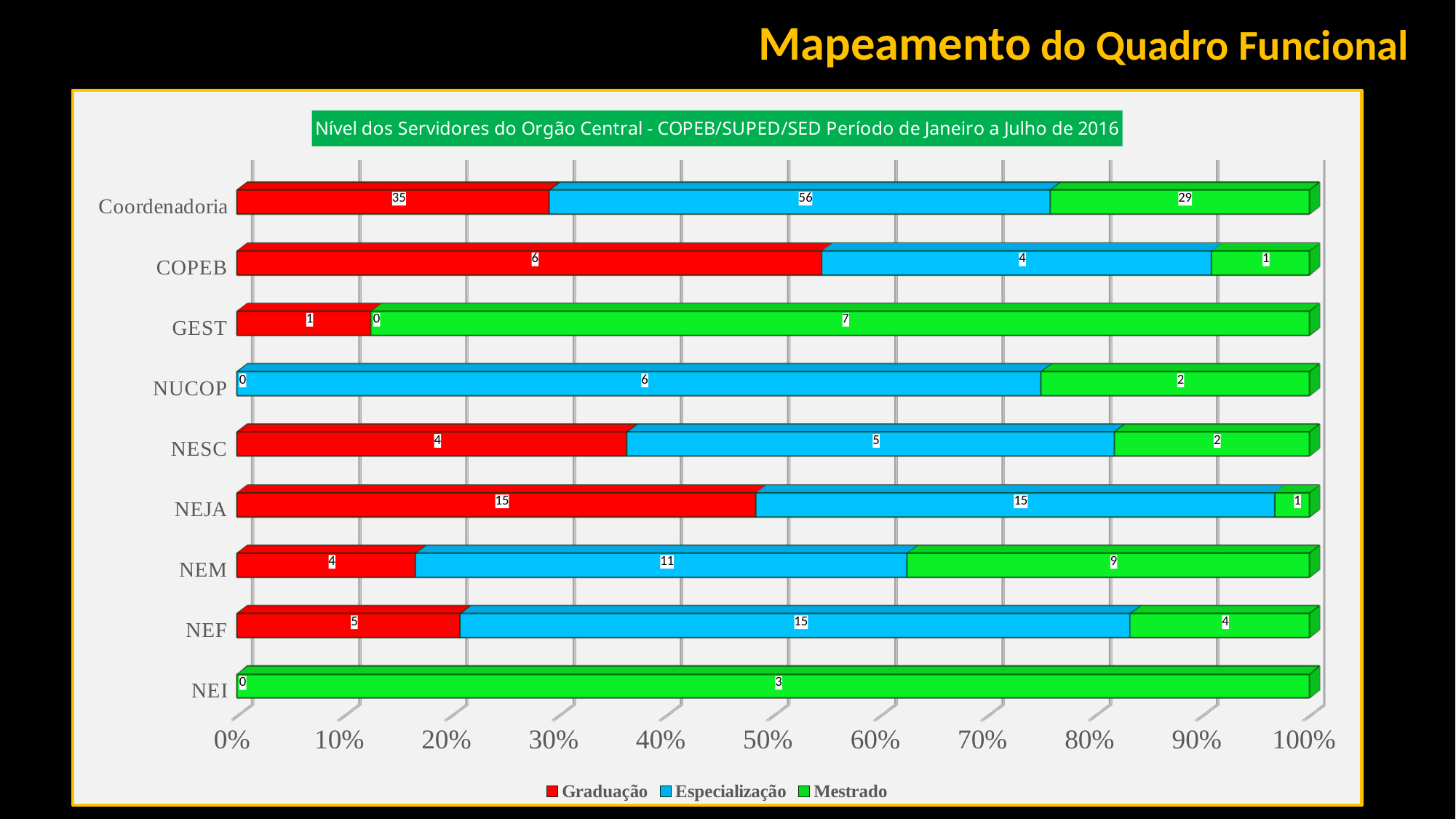
How many series does the legend list? 3 What is the Especialização value for Coordenadoria? 56 What is the Mestrado value for NEM? 9 Which is larger for NEM: the Especialização value or the Graduação value? Especialização What kind of chart is shown on the slide? Stacked bar chart How many categories are shown on the vertical axis? 9 What is the Graduação value for NEJA? 15 What is the total of the three values in the Coordenadoria bar? 120 Which colour represents the Mestrado series in the legend? Green What is the total of the three values in the NEM bar? 24 What is the difference between the Especialização and Graduação values for NEF? 10 Which category has the highest Mestrado value? Coordenadoria